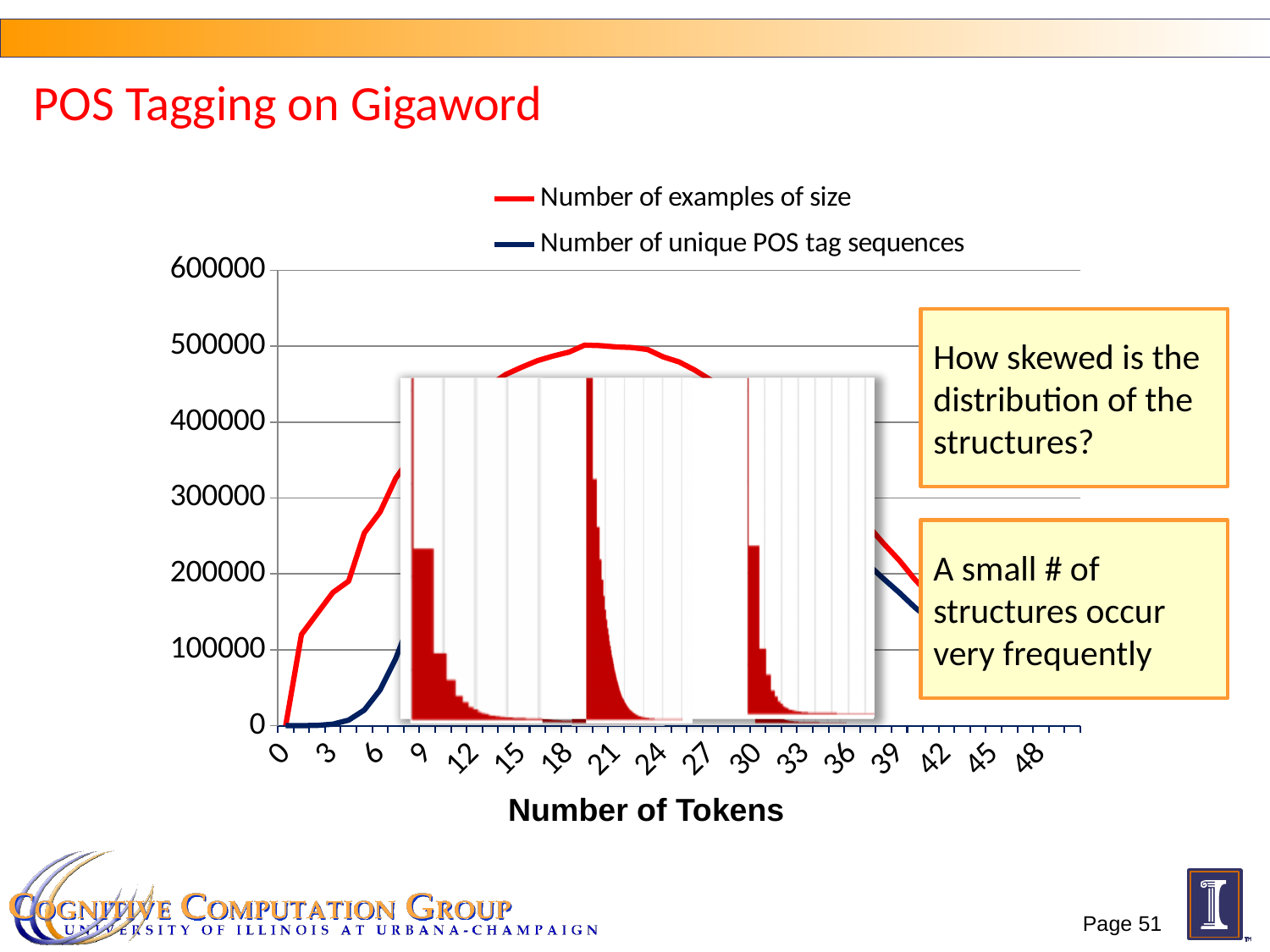
How many series does the legend list? 2 At 6 tokens, which series has the larger value: 'Number of examples of size' or 'Number of unique POS tag sequences'? Number of examples of size Does the 'Number of examples of size' series rise or fall between 0 and 6 tokens? rise Is the value of 'Number of unique POS tag sequences' at 3 tokens greater or less than 100000? less Is the value of 'Number of examples of size' at 3 tokens greater or less than 100000? greater Is the value of 'Number of examples of size' at 6 tokens greater or less than 200000? greater Does the 'Number of examples of size' series rise or fall between 39 and 48 tokens? fall What is the title of the x axis? Number of Tokens What kind of chart is shown on the slide? line chart Which series is drawn in red according to the legend? Number of examples of size